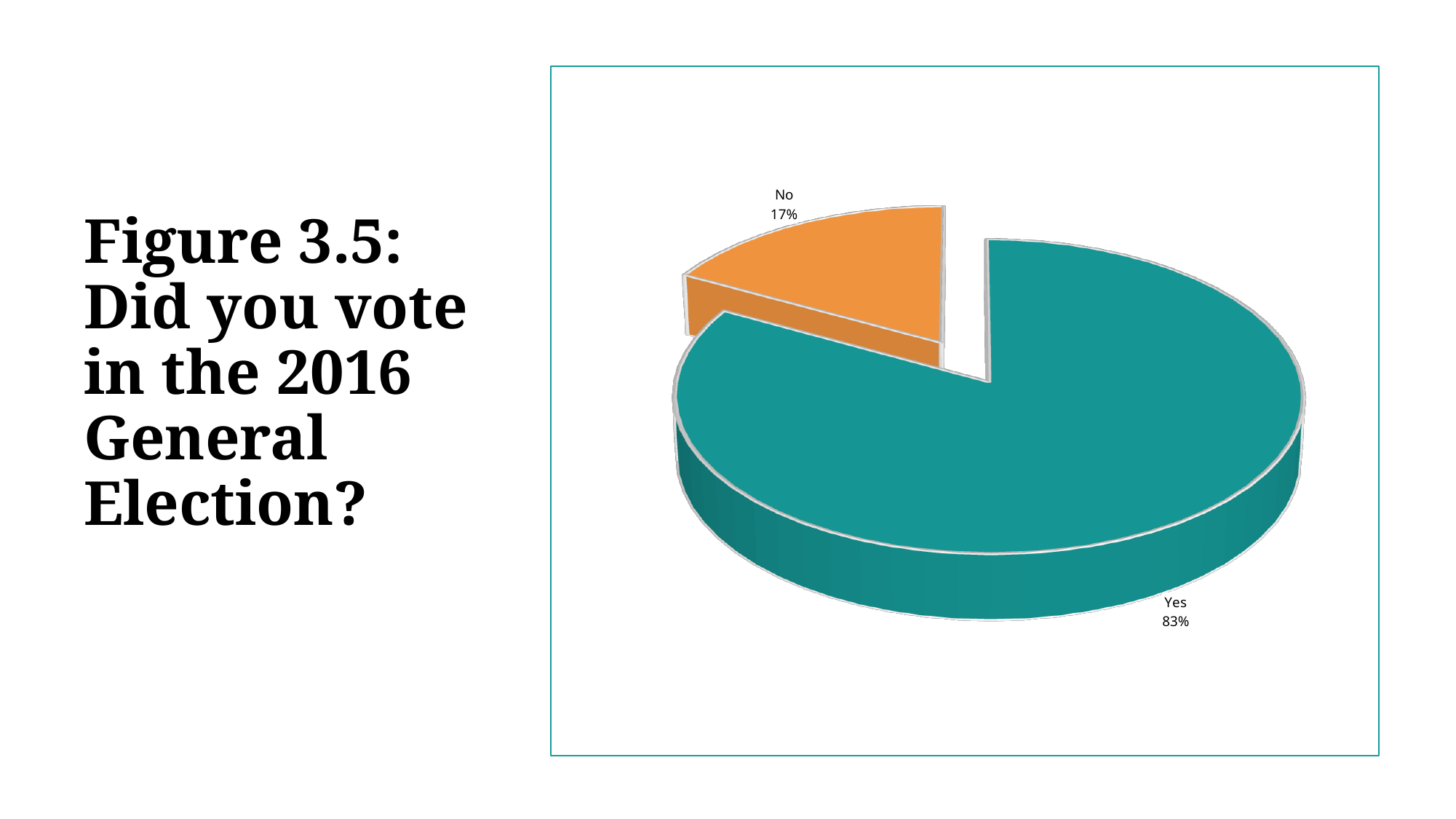
What percentage of respondents answered No? 17% Which is larger, the share for Yes or the share for No? Yes What percentage of respondents answered Yes? 83% Which response has the smallest share of the pie? No How many slices does the pie chart have? 2 What is the title of the figure on the slide? Figure 3.5: Did you vote in the 2016 General Election? What kind of chart is shown on the slide? Pie chart What is the difference in percentage points between the Yes and No shares? 66 Which response has the largest share of the pie? Yes What share of the pie does the No slice represent? 17% What colour is the Yes slice? Teal